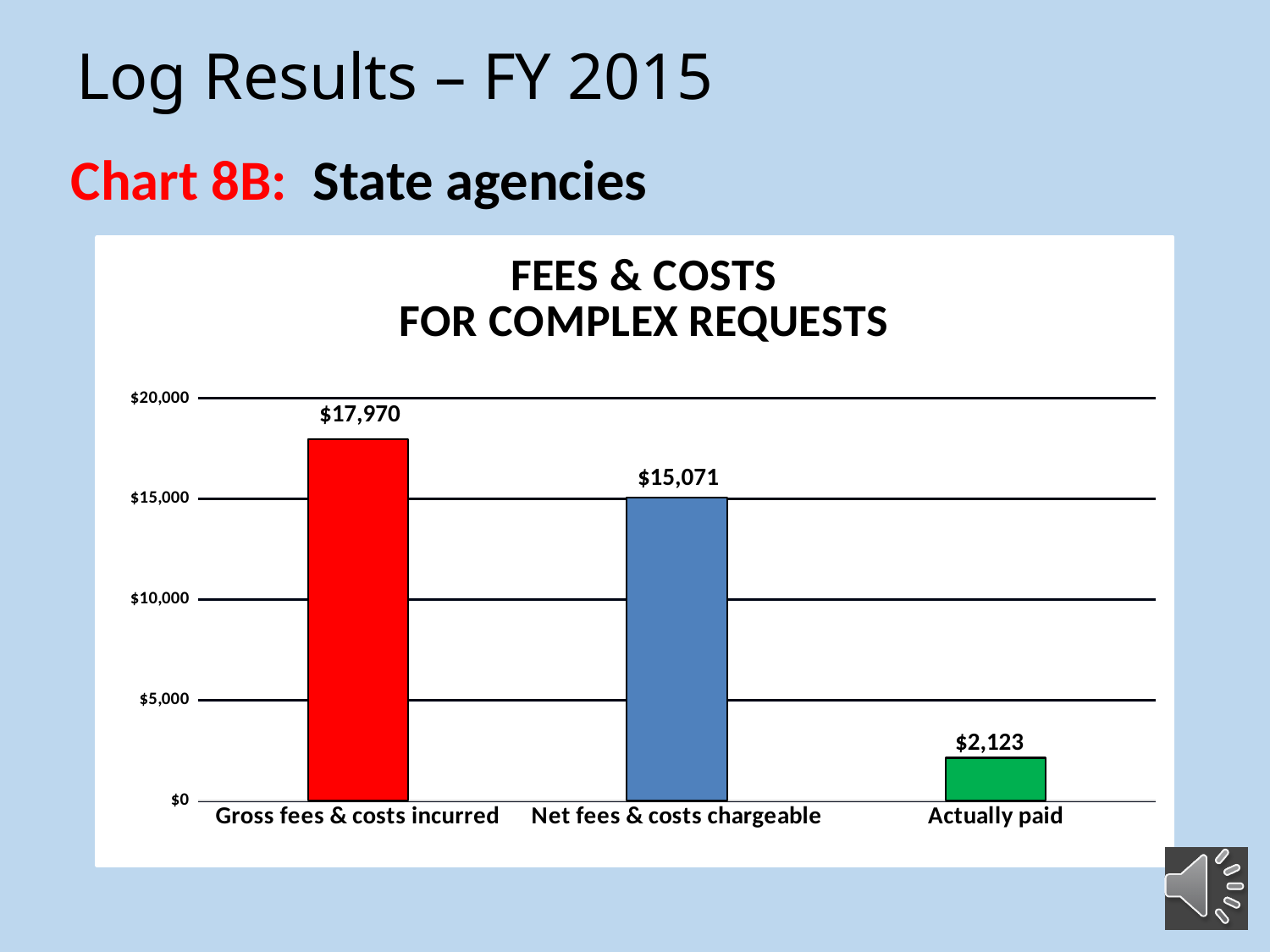
What is the title of the chart? FEES & COSTS FOR COMPLEX REQUESTS What kind of chart is shown on the slide? bar chart What is the difference between Net fees & costs chargeable and Actually paid? $12,948 Which category has the highest value? Gross fees & costs incurred What is the value for Gross fees & costs incurred? $17,970 Is the value for Actually paid greater or less than $5,000? less What is the value for Actually paid? $2,123 What is the difference between Gross fees & costs incurred and Net fees & costs chargeable? $2,899 How many categories are shown in the chart? 3 Which category has the lowest value? Actually paid Which is larger, Net fees & costs chargeable or Actually paid? Net fees & costs chargeable What is the value for Net fees & costs chargeable? $15,071